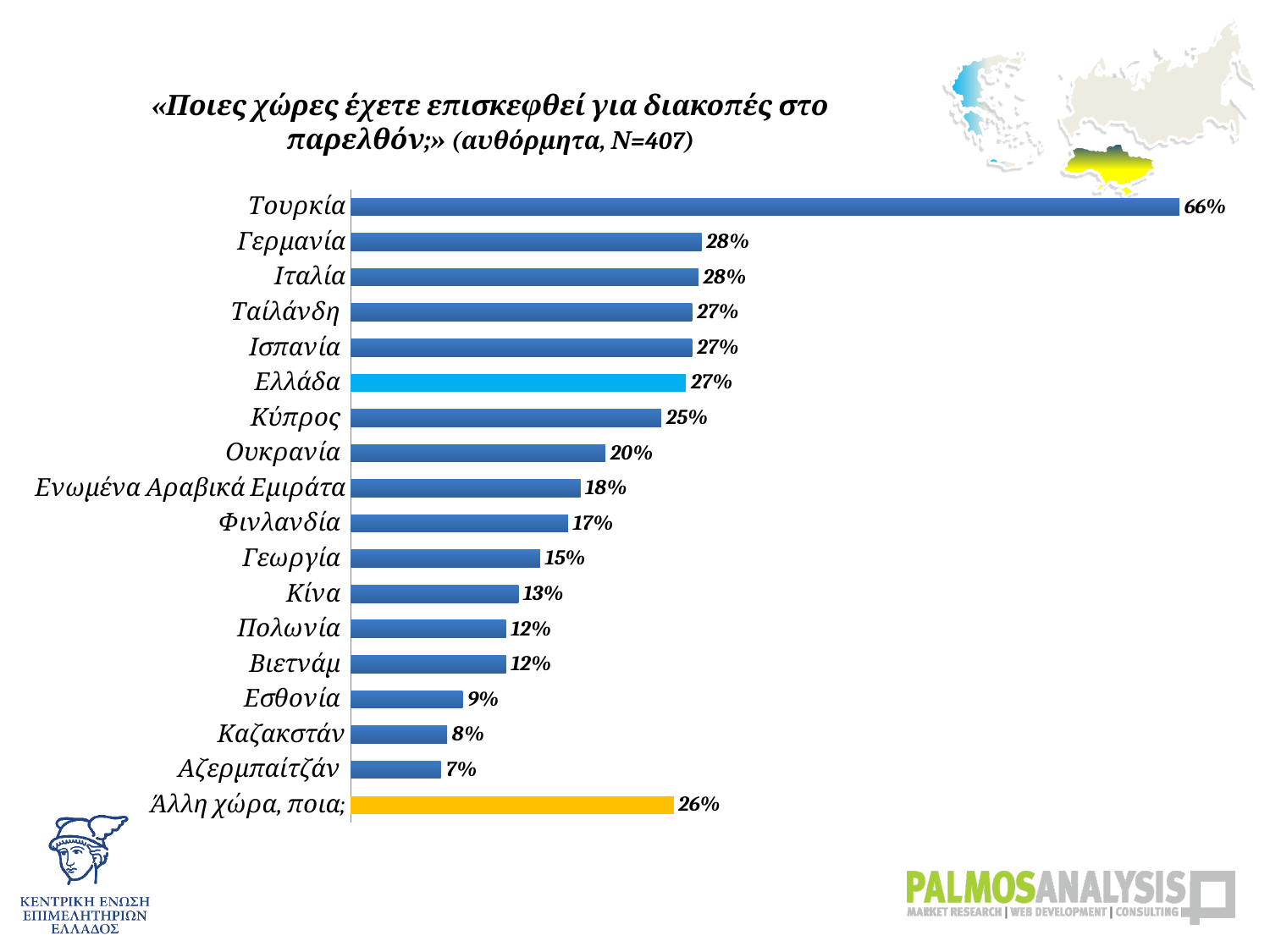
What is the difference between the values for Κύπρος and Φινλανδία? 8% What kind of chart is shown on the slide? Bar chart What is the value for Ελλάδα? 27% What is the value for Τουρκία? 66% Which category has the lowest value? Αζερμπαϊτζάν What is the value for Ουκρανία? 20% Which is larger, the value for Γεωργία or the value for Κίνα? Γεωργία How many categories are shown in the chart? 18 What is the value for Άλλη χώρα, ποια;? 26% Which country has the highest value? Τουρκία Which bar is shown in orange rather than blue? Άλλη χώρα, ποια; What is the difference between the values for Τουρκία and Γερμανία? 38%